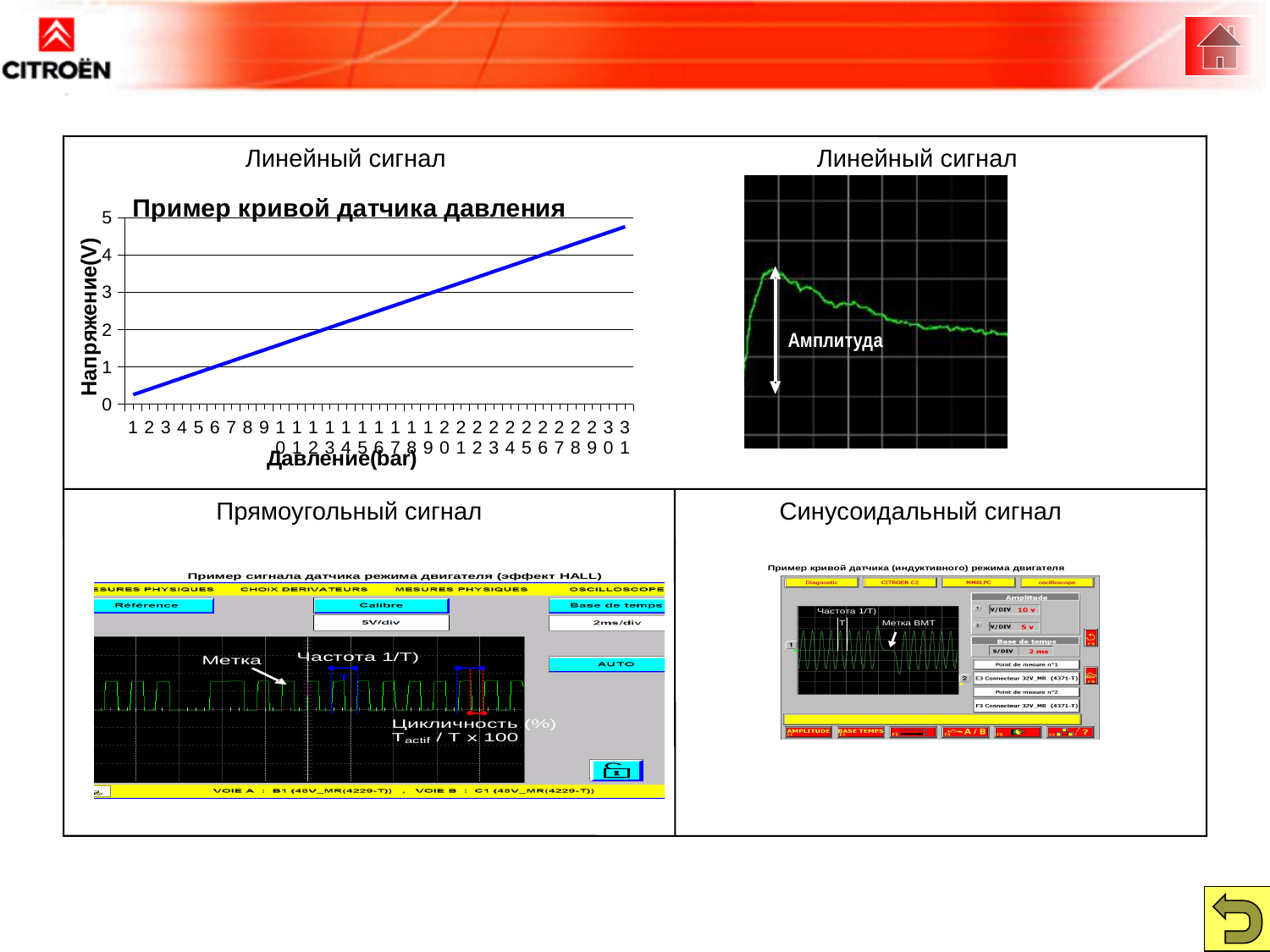
What is the label of the y axis of the chart "Пример кривой датчика давления"? Напряжение(V) In the chart "Пример кривой датчика давления", is the value at Давление 10 greater or less than 2? less In the chart "Пример кривой датчика давления", is the value at Давление 31 greater or less than 4? greater What kind of chart is "Пример кривой датчика давления"? line chart In the chart "Пример кривой датчика давления", is the value at Давление 1 greater or less than 1? less How many Давление(bar) points are shown on the x axis of the chart "Пример кривой датчика давления"? 31 In the chart "Пример кривой датчика давления", do the values rise or fall as Давление(bar) increases? rise In the chart "Пример кривой датчика давления", at which Давление value is the voltage lowest? 1 What is the highest value shown on the y axis of the chart "Пример кривой датчика давления"? 5 In the chart "Пример кривой датчика давления", which has the larger voltage: Давление 1 or Давление 31? 31 In the chart "Пример кривой датчика давления", at which Давление value is the voltage highest? 31